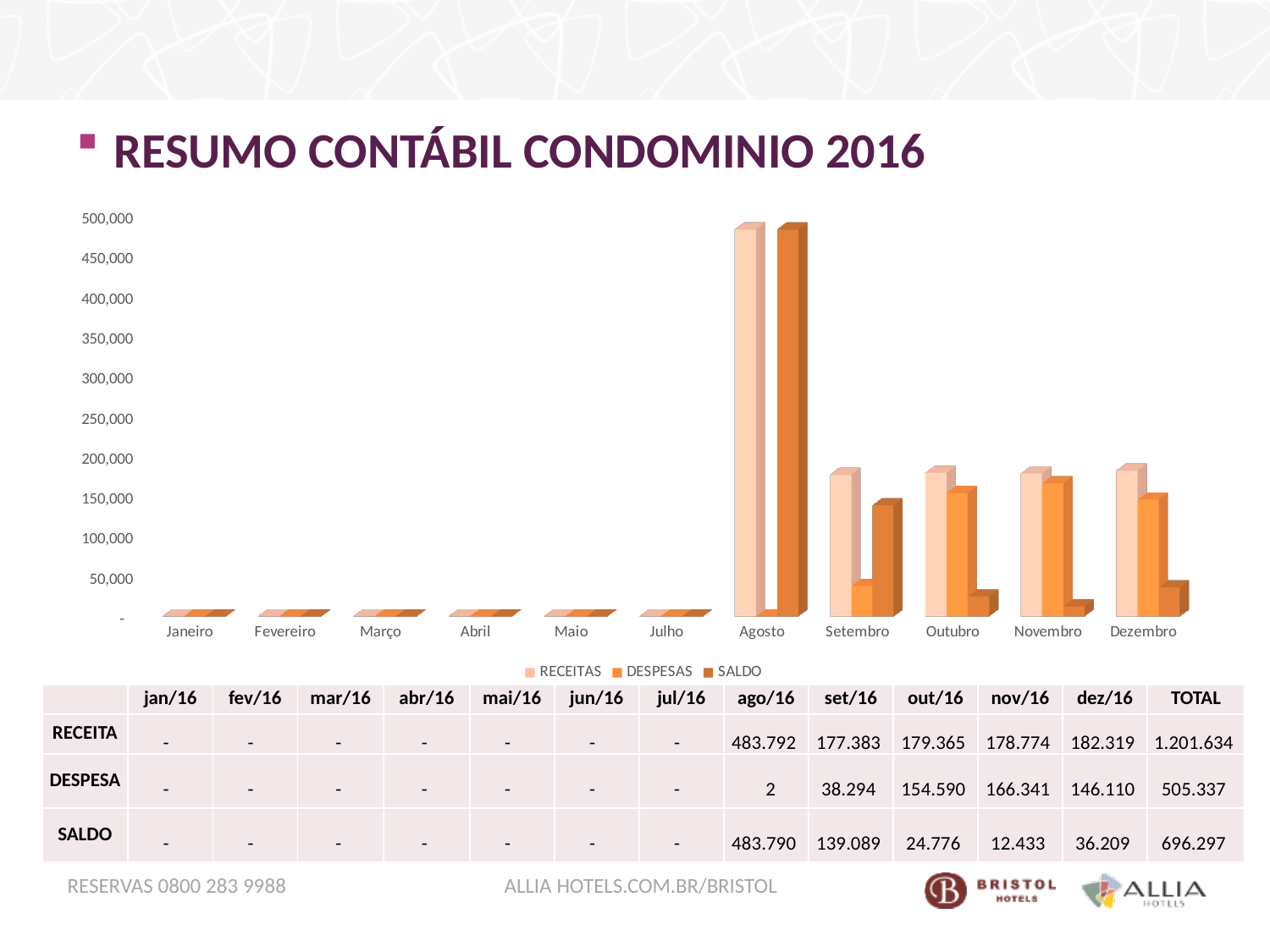
What is the difference between RECEITA and DESPESA for set/16? 139.089 Which is larger, the DESPESA for out/16 or for nov/16? nov/16 How many series does the chart legend list? 3 Is the RECEITAS bar for Agosto greater or less than 450,000? greater What are the three entries in the chart legend? RECEITAS, DESPESAS, SALDO How many month categories are shown along the x axis of the chart? 11 What kind of chart is shown on the slide? bar chart Which month has the highest RECEITAS bar? Agosto Among the months with values, which month has the lowest SALDO? nov/16 What is the TOTAL SALDO shown in the table? 696.297 Do the DESPESAS bars rise or fall from Agosto to Novembro? rise What is the RECEITA value for ago/16 in the table? 483.792